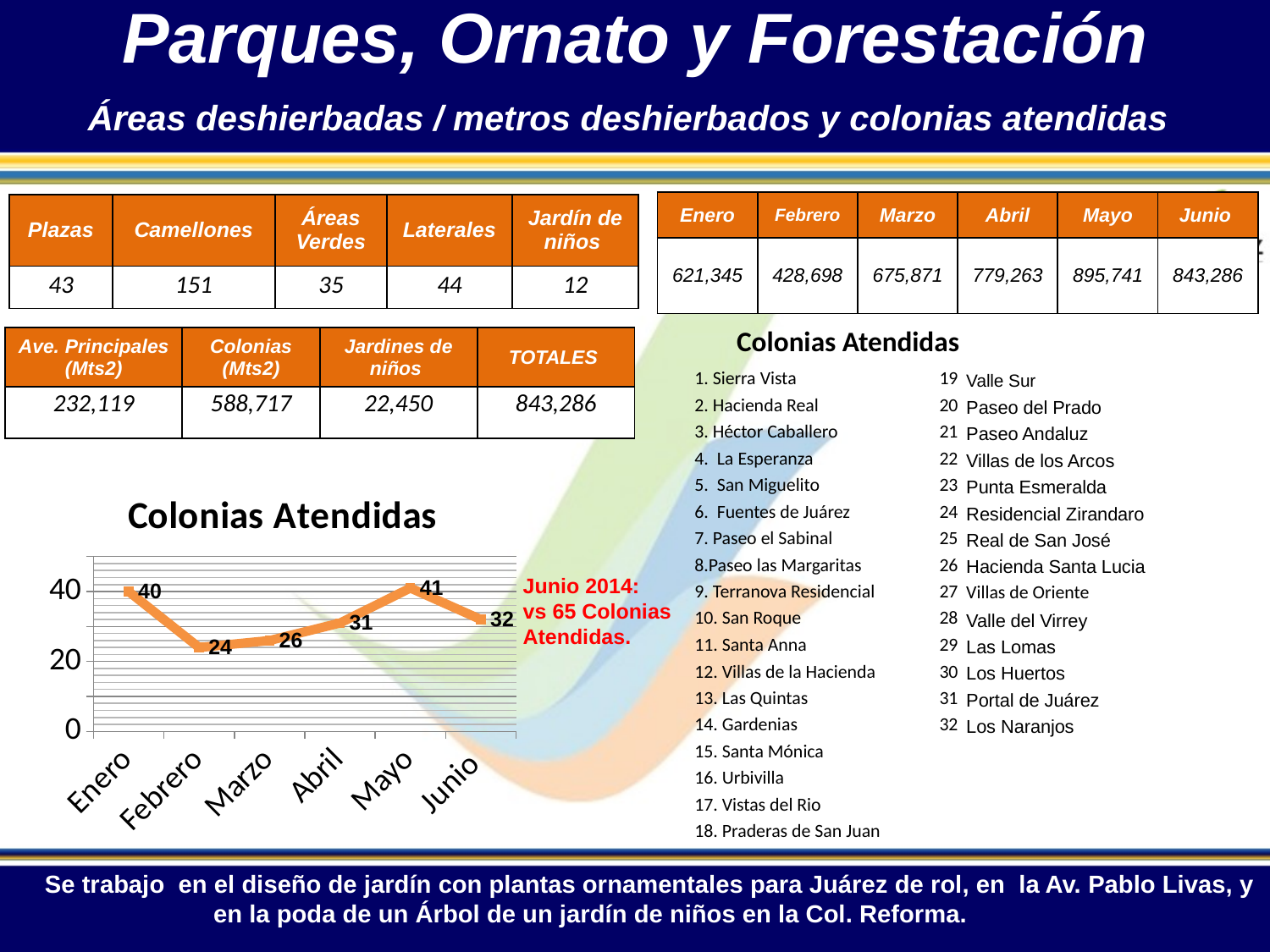
Which month has the lowest value in the Colonias Atendidas chart? Febrero What is the value for Abril in the Colonias Atendidas chart? 31 What is the value for Enero in the Colonias Atendidas chart? 40 What is the title of the chart on the slide? Colonias Atendidas What is the difference between the values for Mayo and Febrero in the Colonias Atendidas chart? 17 Does the value in the Colonias Atendidas chart rise or fall from Febrero to Mayo? rise What is the value for Junio in the Colonias Atendidas chart? 32 How many months are plotted in the Colonias Atendidas chart? 6 What is the value for Febrero in the Colonias Atendidas chart? 24 What kind of chart is the Colonias Atendidas chart? line chart Which is larger in the Colonias Atendidas chart, the value for Enero or the value for Junio? Enero Which month has the highest value in the Colonias Atendidas chart? Mayo